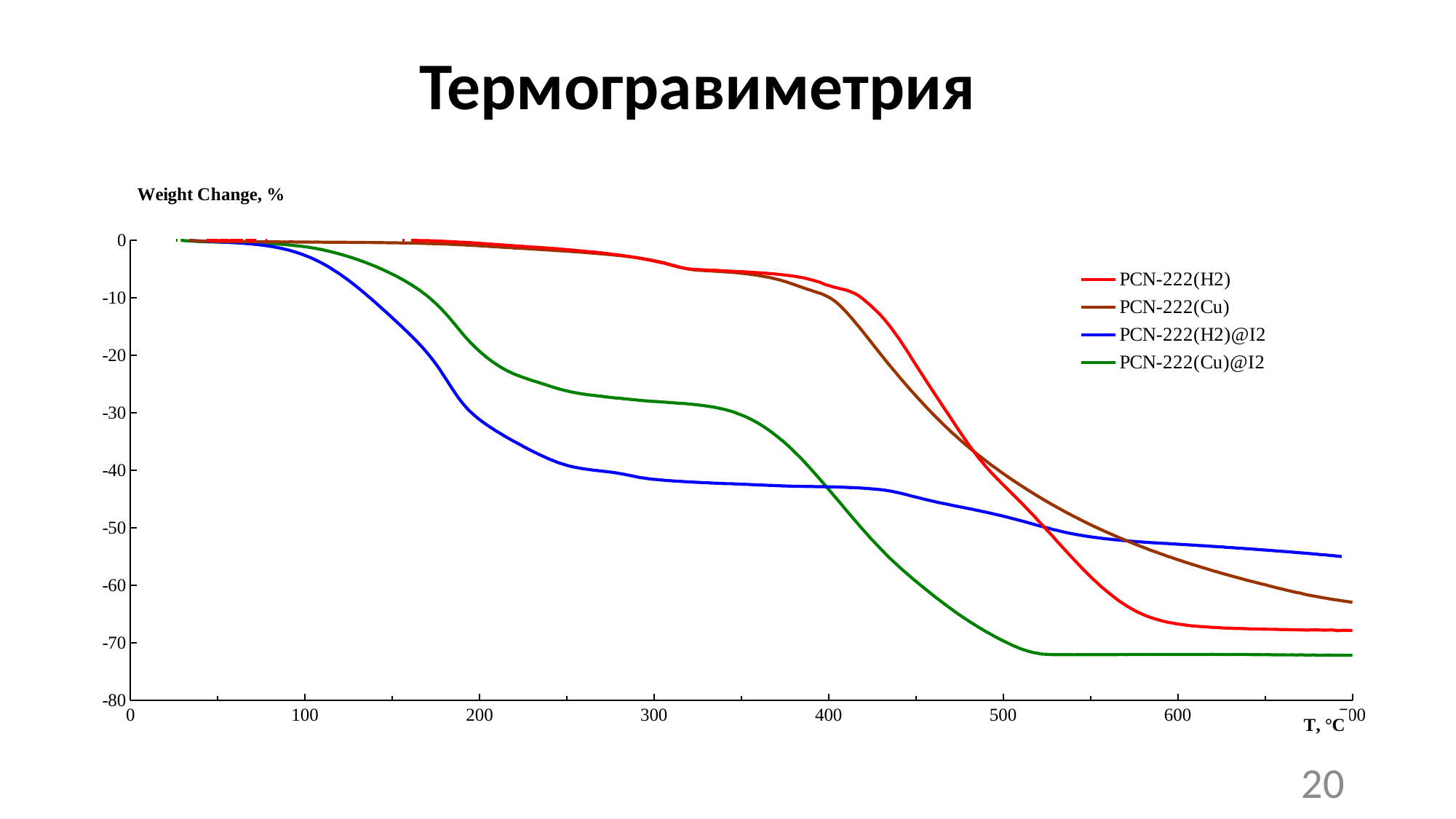
At 600 °C, which series has a higher weight change value, PCN-222(H2)@I2 or PCN-222(Cu)@I2? PCN-222(H2)@I2 Is the value for PCN-222(Cu) at 450 °C greater or less than -20? less Is the value for PCN-222(H2)@I2 at 300 °C greater or less than -40? less Is the value for PCN-222(H2) at 300 °C greater or less than -10? greater Which series has the lowest weight change value at 600 °C? PCN-222(Cu)@I2 What is the label of the y axis? Weight Change, % What kind of chart is shown on the slide? line chart At 300 °C, which series has a lower weight change value, PCN-222(H2)@I2 or PCN-222(Cu)@I2? PCN-222(H2)@I2 How many series does the legend list? 4 What colour is the PCN-222(Cu)@I2 line in the legend? green Do the weight change values rise or fall as temperature increases along the x axis? fall